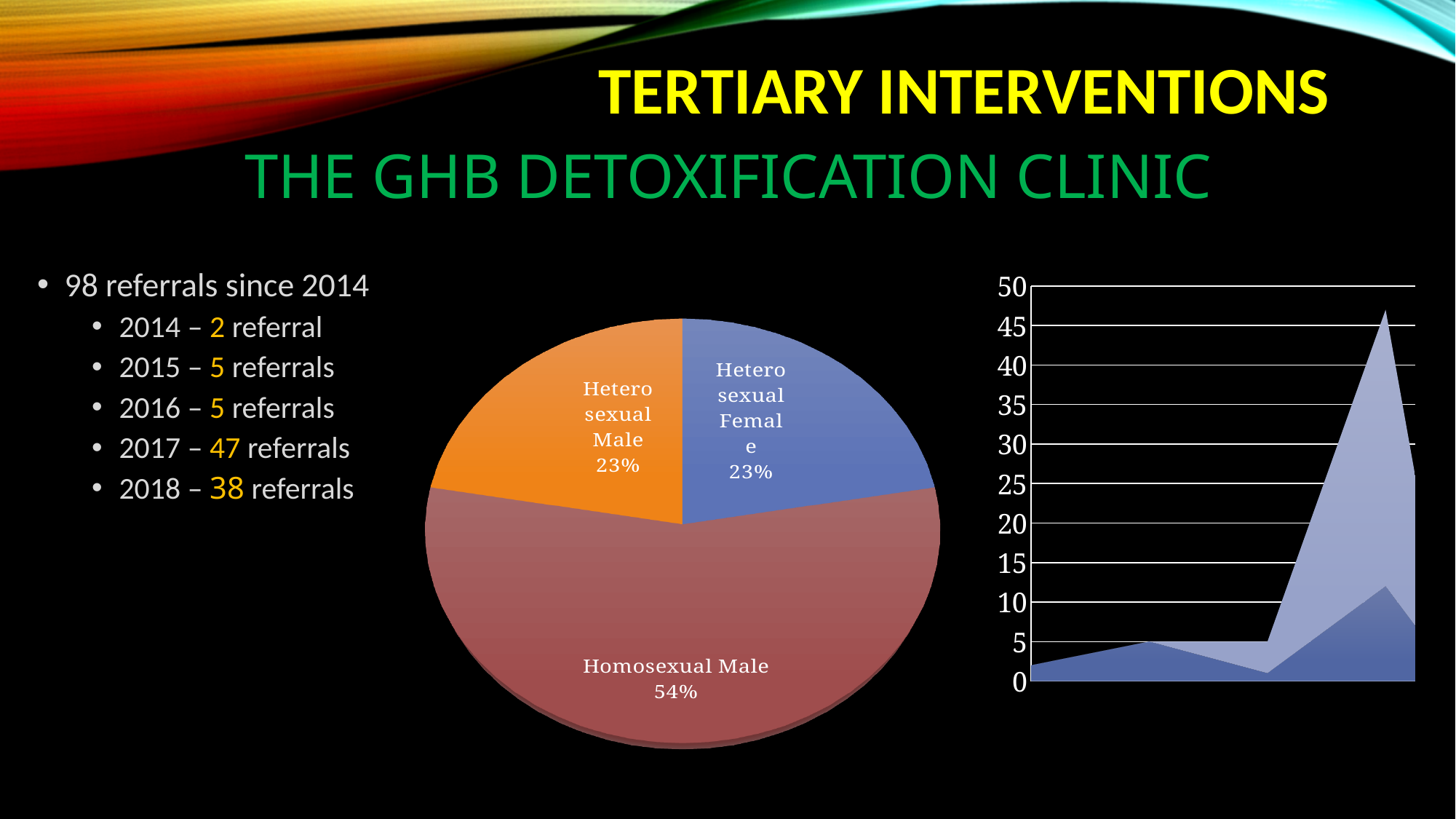
In the pie chart, what share is labelled for Homosexual Male? 54% In the pie chart, which is larger, the Homosexual Male slice or the Heterosexual Male slice? Homosexual Male In the pie chart, what colour is the Heterosexual Male slice? Orange In the pie chart, which category has the largest slice? Homosexual Male In the pie chart, what percentage is shown for Heterosexual Female? 23% In the pie chart, what percentage is shown for Heterosexual Male? 23% In the chart on the right, what is the highest value shown on the vertical axis? 50 In the chart on the right, is the highest point of the lighter series greater or less than 40? greater What kind of chart is the chart on the right of the slide? Area chart In the pie chart, how many slices are there? 3 In the pie chart, what is the difference in percentage points between Homosexual Male and Heterosexual Female? 31 What kind of chart is the chart in the middle of the slide? Pie chart